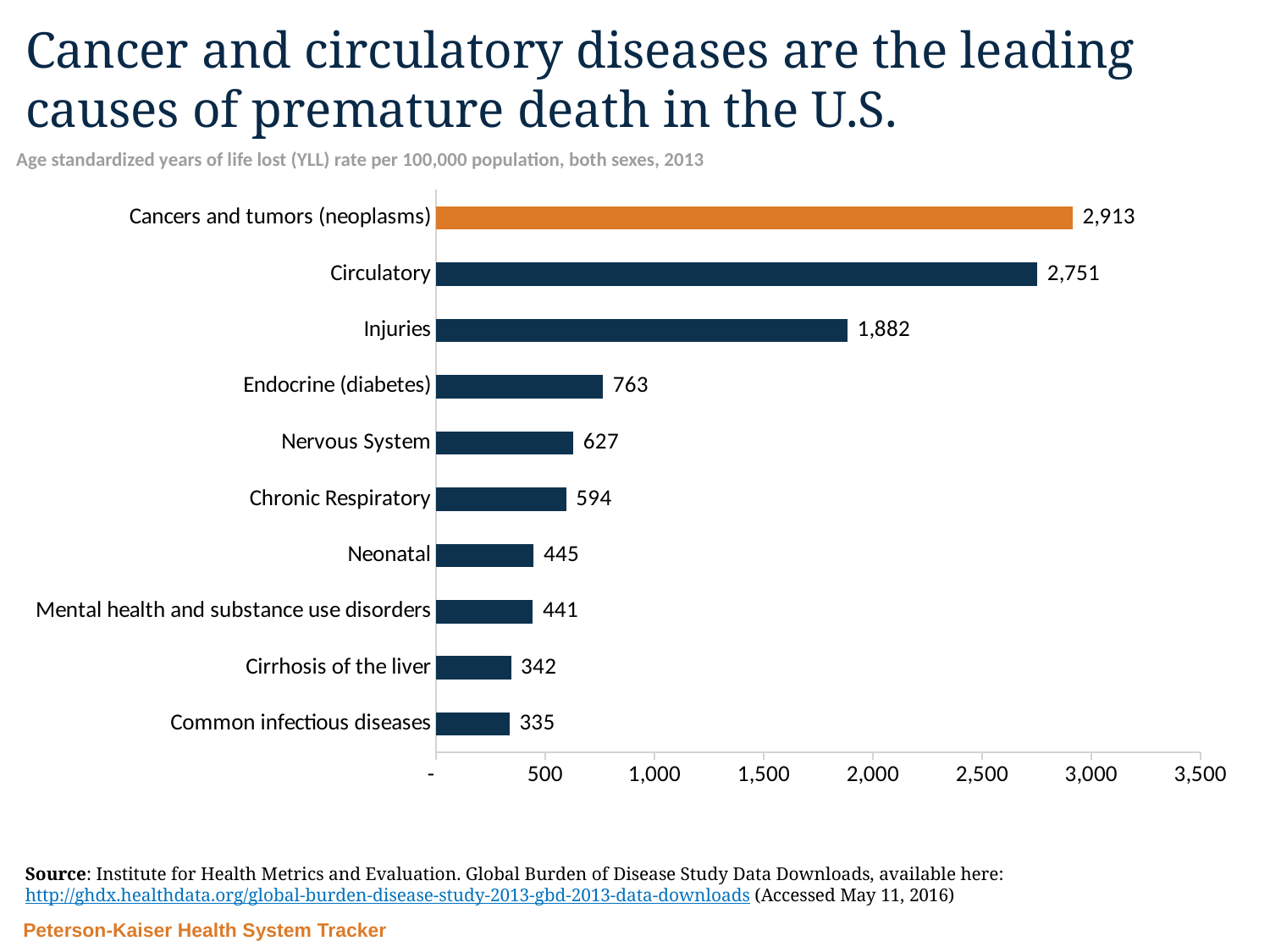
Which category has the highest YLL rate? Cancers and tumors (neoplasms) What is the YLL rate for Endocrine (diabetes)? 763 Which bar is coloured orange rather than dark blue? Cancers and tumors (neoplasms) What kind of chart is shown on the slide? Bar chart Which category has the lowest YLL rate? Common infectious diseases Is the value for Circulatory greater or less than 2,500? greater What is the YLL rate for Injuries? 1,882 What is the YLL rate for Cancers and tumors (neoplasms)? 2,913 Which has a higher YLL rate, Injuries or Endocrine (diabetes)? Injuries What is the difference between the YLL rates for Nervous System and Chronic Respiratory? 33 How many categories are shown in the chart? 10 What is the difference between the YLL rates for Cancers and tumors (neoplasms) and Circulatory? 162